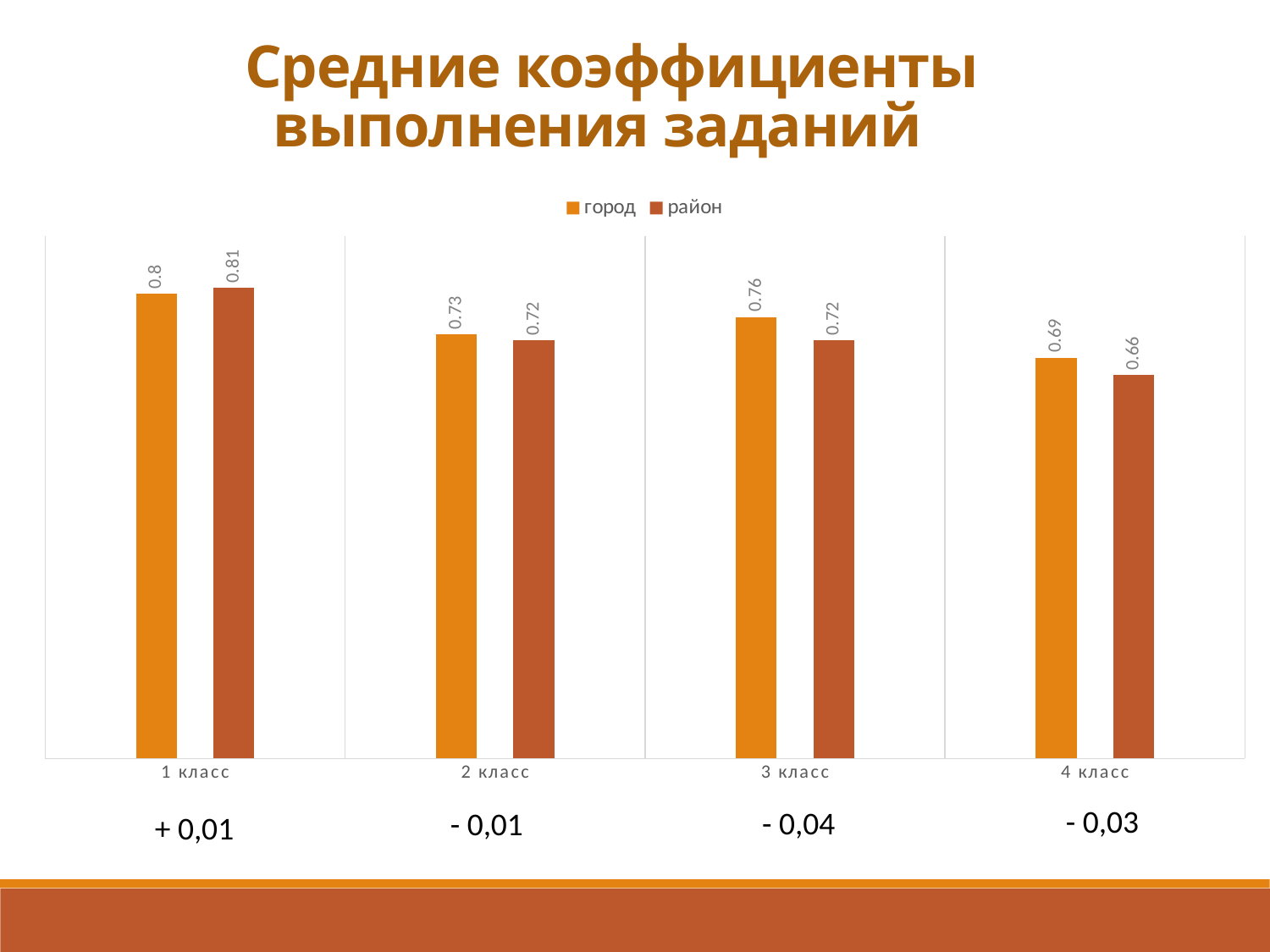
Which class has the lowest value for город? 4 класс Which class has the highest value for район? 1 класс What are the two series named in the legend? город and район What is the value for город in 3 класс? 0.76 Which is larger in 4 класс, город or район? город How many classes (categories) are shown on the x axis? 4 What is the value for район in 4 класс? 0.66 How many series does the legend list? 2 What kind of chart is shown on the slide? bar chart What is the value for район in 2 класс? 0.72 What is the value for город in 1 класс? 0.8 What is the difference between город and район in 3 класс? 0.04